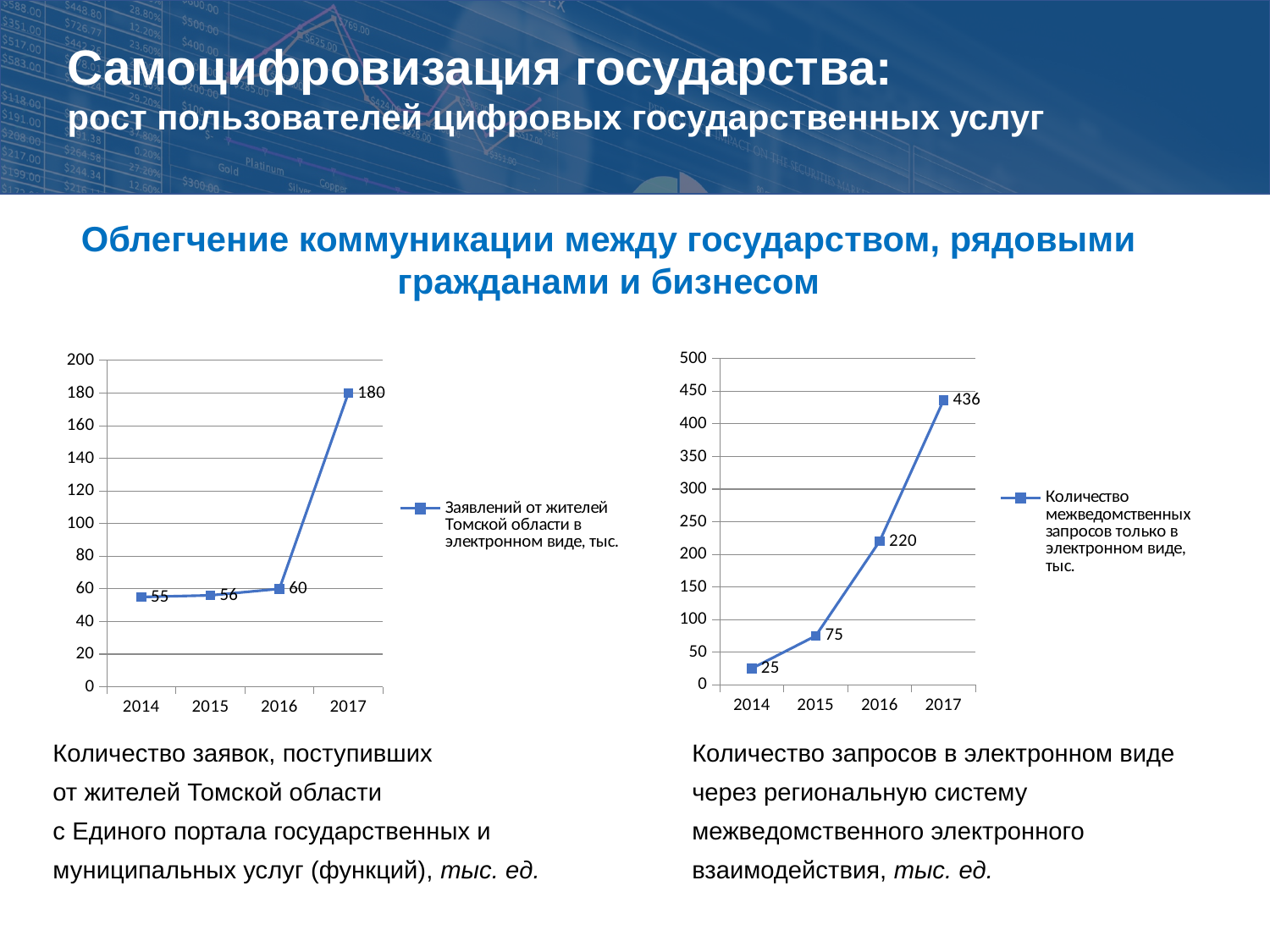
In the right chart, what is the value for 2016? 220 In the left chart, what is the value for 2014? 55 In the right chart, what is the value for 2017? 436 How many years are plotted on the x axis of the left chart? 4 In the right chart, is the value for 2015 greater or less than 100? less In the right chart, which year has the lowest value? 2014 In the right chart, do the values rise or fall from 2014 to 2017? rise In the right chart, what is the difference between the values for 2016 and 2015? 145 In the left chart, what is the value for 2017? 180 In the left chart, which year has the highest value? 2017 In the left chart, what is the difference between the values for 2017 and 2016? 120 What type of chart is the right chart? line chart